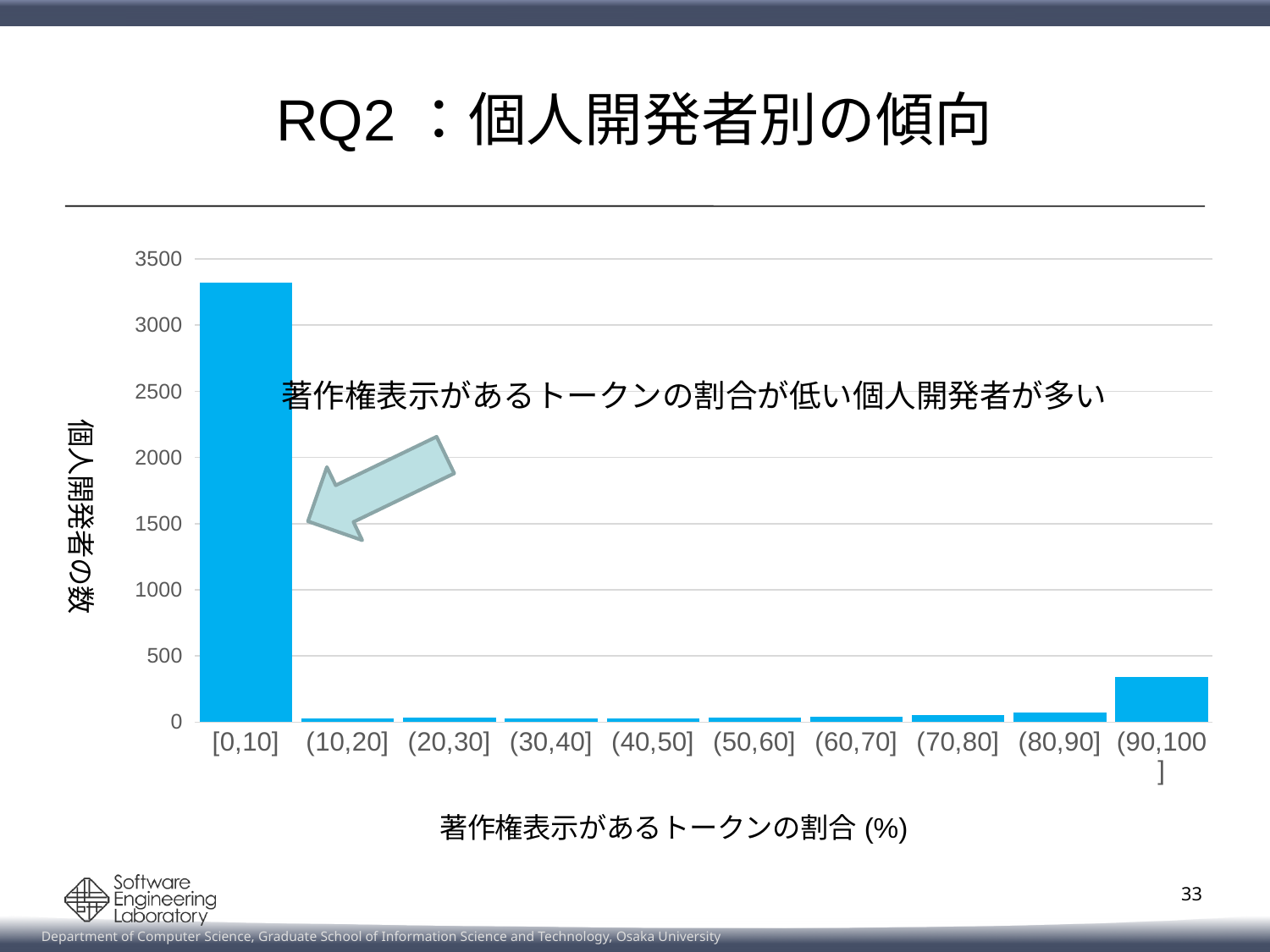
Which is larger, the value for (90,100] or the value for (10,20]? (90,100] Is the value for (50,60] greater or less than 500? less What kind of chart is shown on the slide? bar chart What is the x-axis title of the chart? 著作権表示があるトークンの割合 (%) Which category has the highest number of individual developers? [0,10] Which is larger, the value for (80,90] or the value for [0,10]? [0,10] Which is larger, the value for [0,10] or the value for (90,100]? [0,10] What is the highest value shown on the y axis of the chart? 3500 Is the value for (90,100] greater or less than 500? less How many categories (bins) are shown on the x axis of the chart? 10 Is the value for [0,10] greater or less than 3000? greater